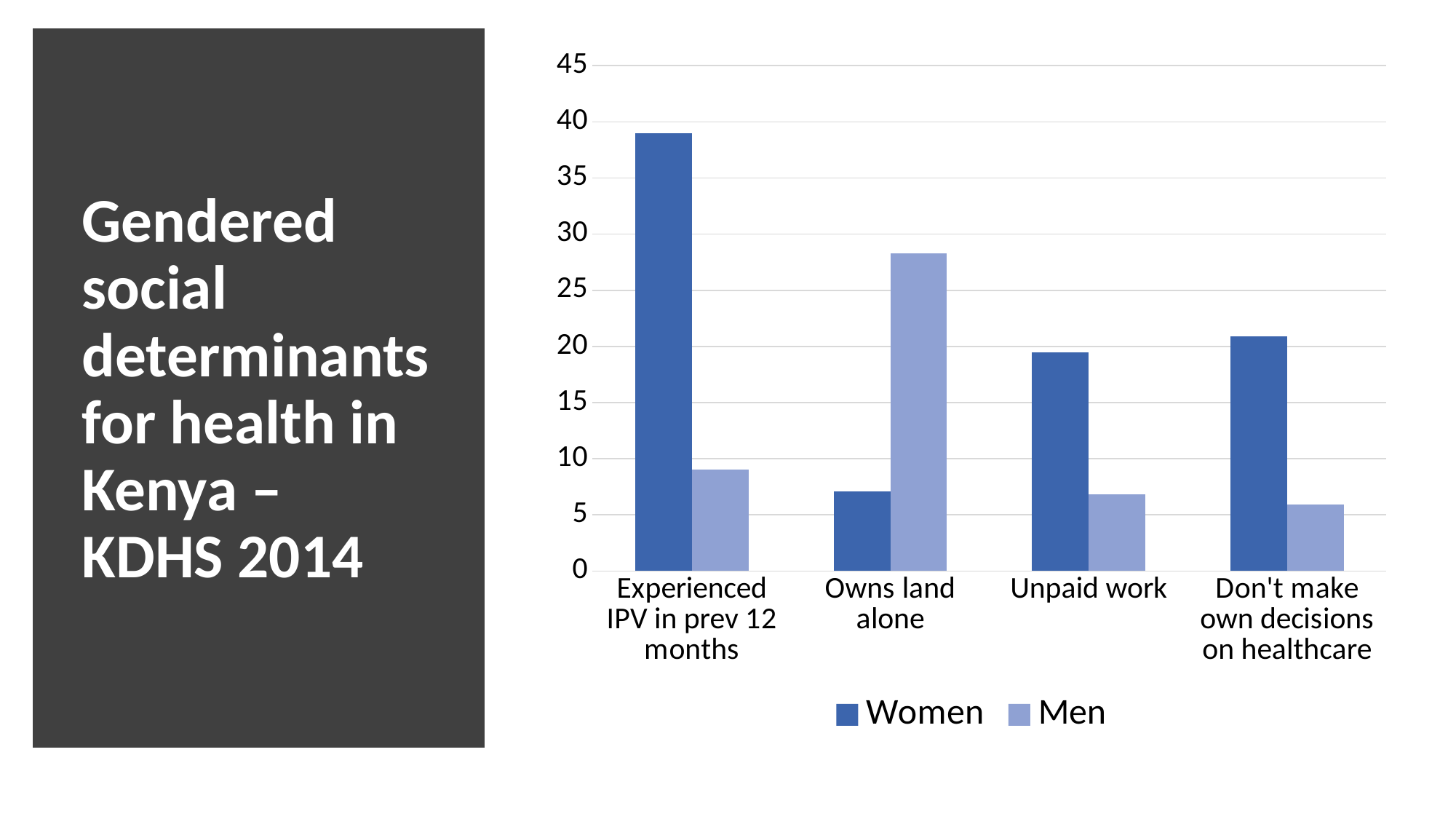
For Don't make own decisions on healthcare, which is larger, the value for Women or for Men? Women For Owns land alone, which is larger, the value for Women or for Men? Men Is the value for Men in Owns land alone greater or less than 25? greater Which category has the lowest value for Women? Owns land alone How many series does the legend list? 2 Is the value for Women in Experienced IPV in prev 12 months greater or less than 35? greater Is the value for Women in Unpaid work greater or less than 15? greater Which category has the highest value for Men? Owns land alone Which category has the highest value for Women? Experienced IPV in prev 12 months How many categories are shown on the x axis? 4 What kind of chart is shown on the slide? bar chart